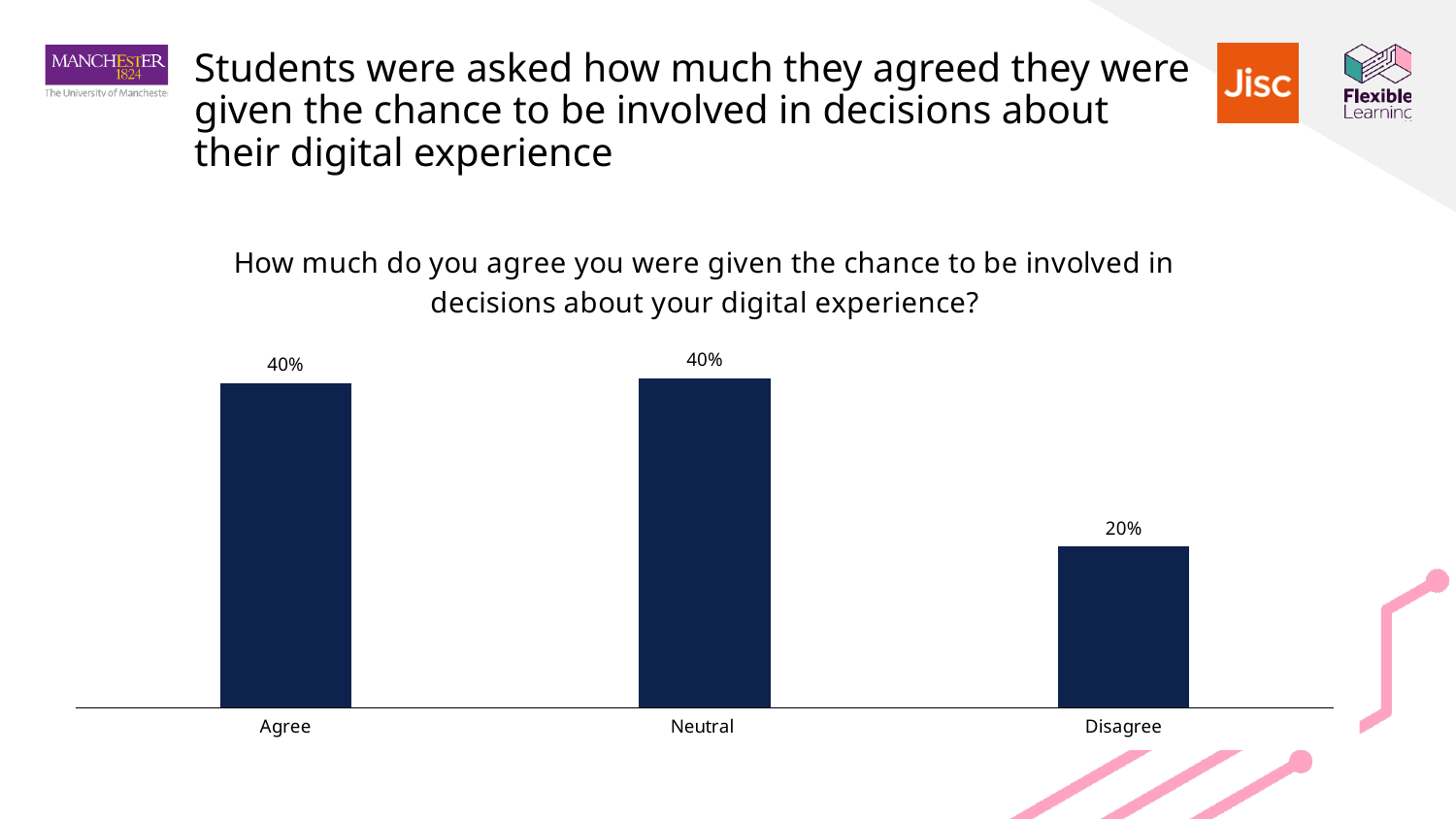
How many response categories are shown on the x axis? 3 What is the difference between the Neutral and Disagree values? 20% What kind of chart is shown on the slide? Bar chart What percentage of students answered Neutral? 40% Which response category has the lowest value? Disagree What is the difference between the Agree and Disagree values? 20% What is the title of the chart? How much do you agree you were given the chance to be involved in decisions about your digital experience? What percentage of students answered Disagree? 20% Which is larger, the value for Agree or the value for Disagree? Agree What percentage of students answered Agree? 40% What is the total of the three percentages shown on the chart? 100% Which is larger, the value for Neutral or the value for Disagree? Neutral